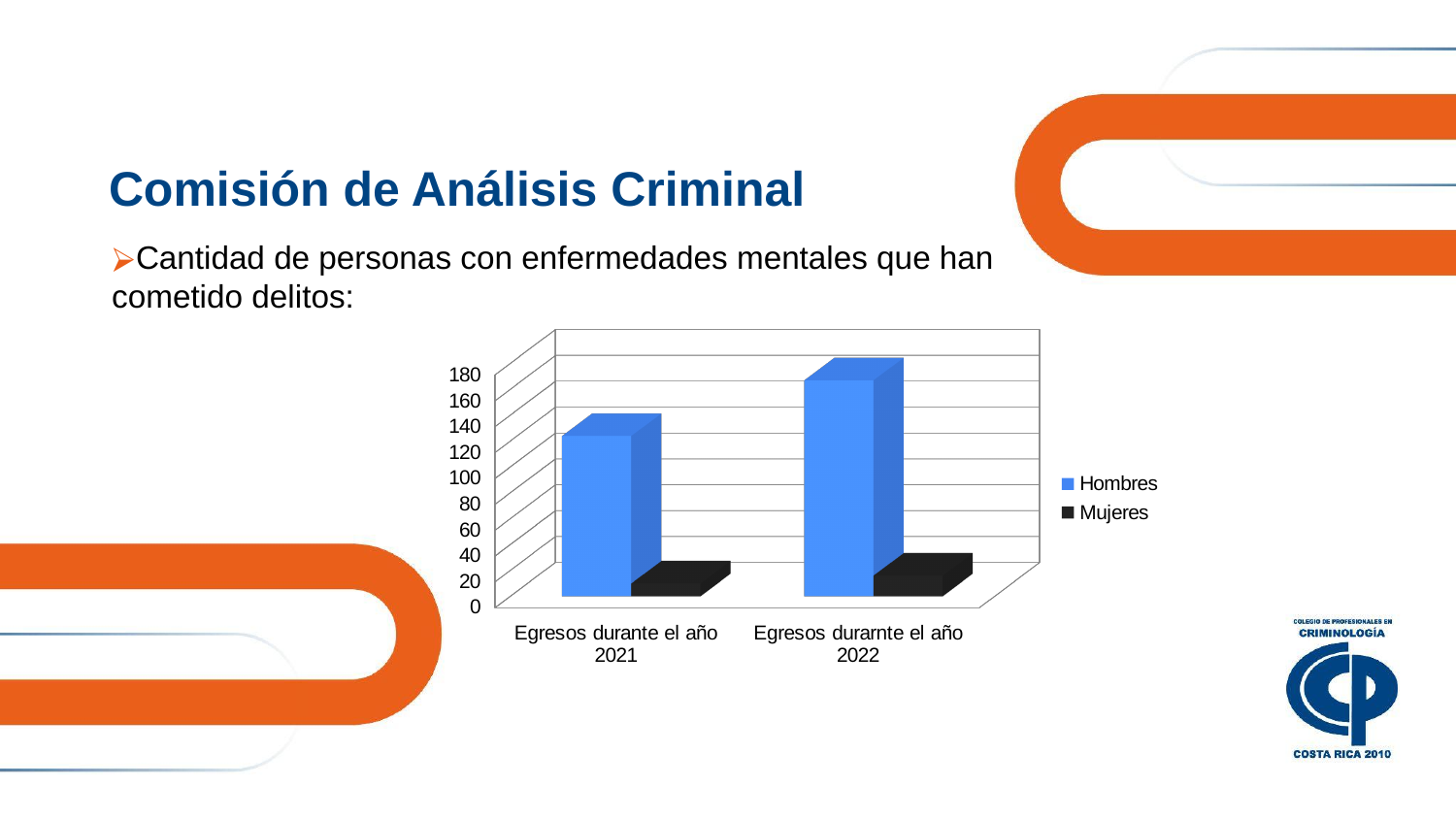
Do the values for Hombres rise or fall from 2021 to 2022? Rise What kind of chart is shown on the slide? Bar chart Which series is shown in black? Mujeres Which series is shown in blue? Hombres Is the value for Hombres in Egresos durante el año 2021 greater or less than 160? less How many categories are shown on the x axis? 2 Is the value for Mujeres in Egresos durante el año 2021 greater or less than 40? less How many series does the legend list? 2 Is the value for Hombres in Egresos durarnte el año 2022 greater or less than 160? greater Which is larger: Hombres in Egresos durante el año 2021 or Hombres in Egresos durarnte el año 2022? Hombres in Egresos durarnte el año 2022 Which bar is the highest in the chart? Hombres, Egresos durarnte el año 2022